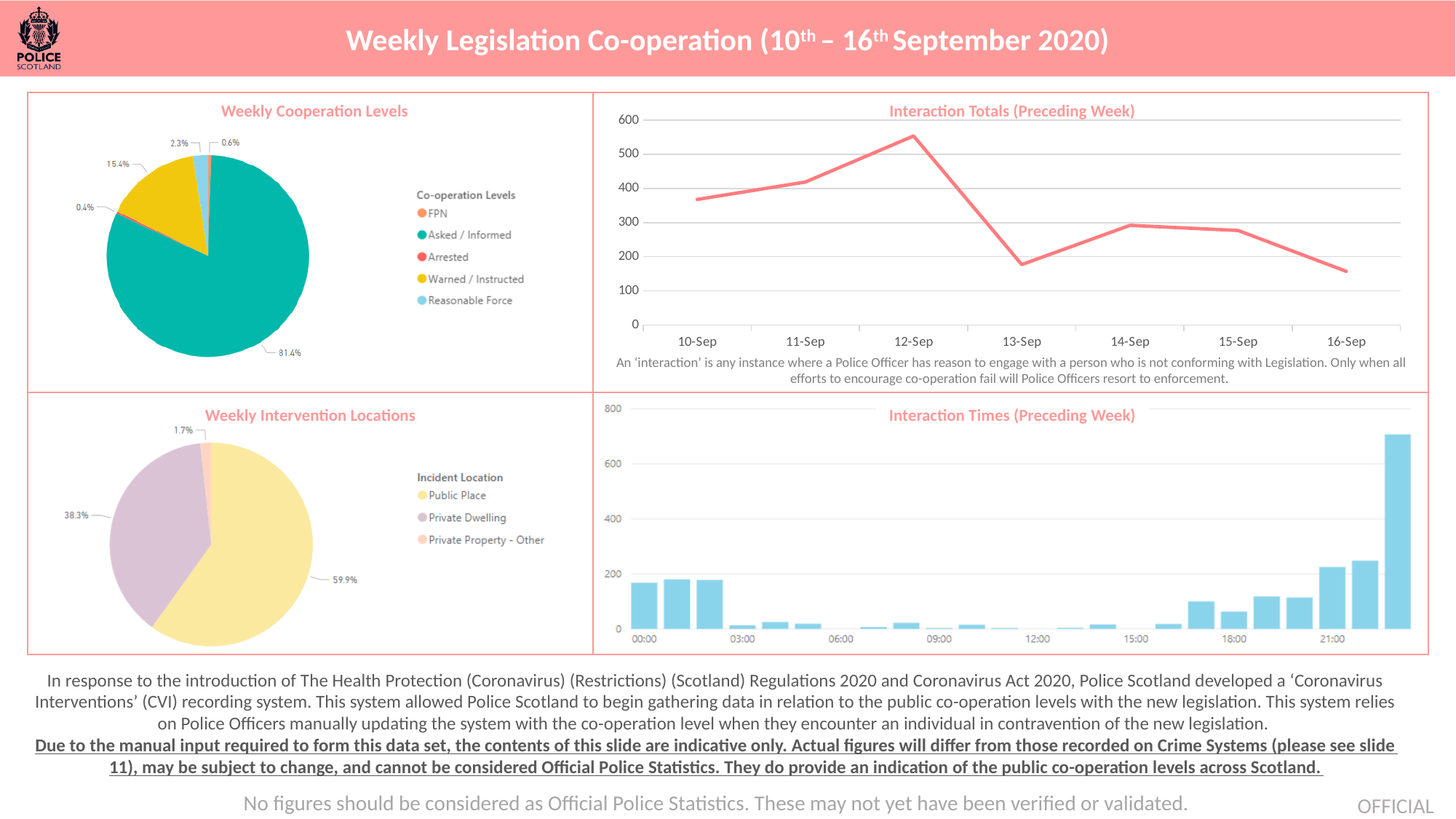
What kind of chart is Interaction Times (Preceding Week)? bar chart In the Interaction Totals (Preceding Week) chart, is the value for 12-Sep greater or less than 500? greater In the Interaction Times (Preceding Week) chart, is the value for the tallest bar greater or less than 600? greater In the Weekly Intervention Locations pie chart, what is the difference between the Public Place and Private Dwelling shares? 21.6% In the Weekly Cooperation Levels pie chart, what share is Warned / Instructed? 15.4% In the Weekly Cooperation Levels pie chart, what share is Asked / Informed? 81.4% In the Interaction Totals (Preceding Week) chart, which date has the highest interaction total? 12-Sep In the Interaction Totals (Preceding Week) chart, is the value for 13-Sep greater or less than 200? less In the Weekly Intervention Locations pie chart, which incident location has the largest share? Public Place How many co-operation levels does the legend of the Weekly Cooperation Levels chart list? 5 How many dates are plotted in the Interaction Totals (Preceding Week) chart? 7 In the Weekly Intervention Locations pie chart, what share is Private Dwelling? 38.3%